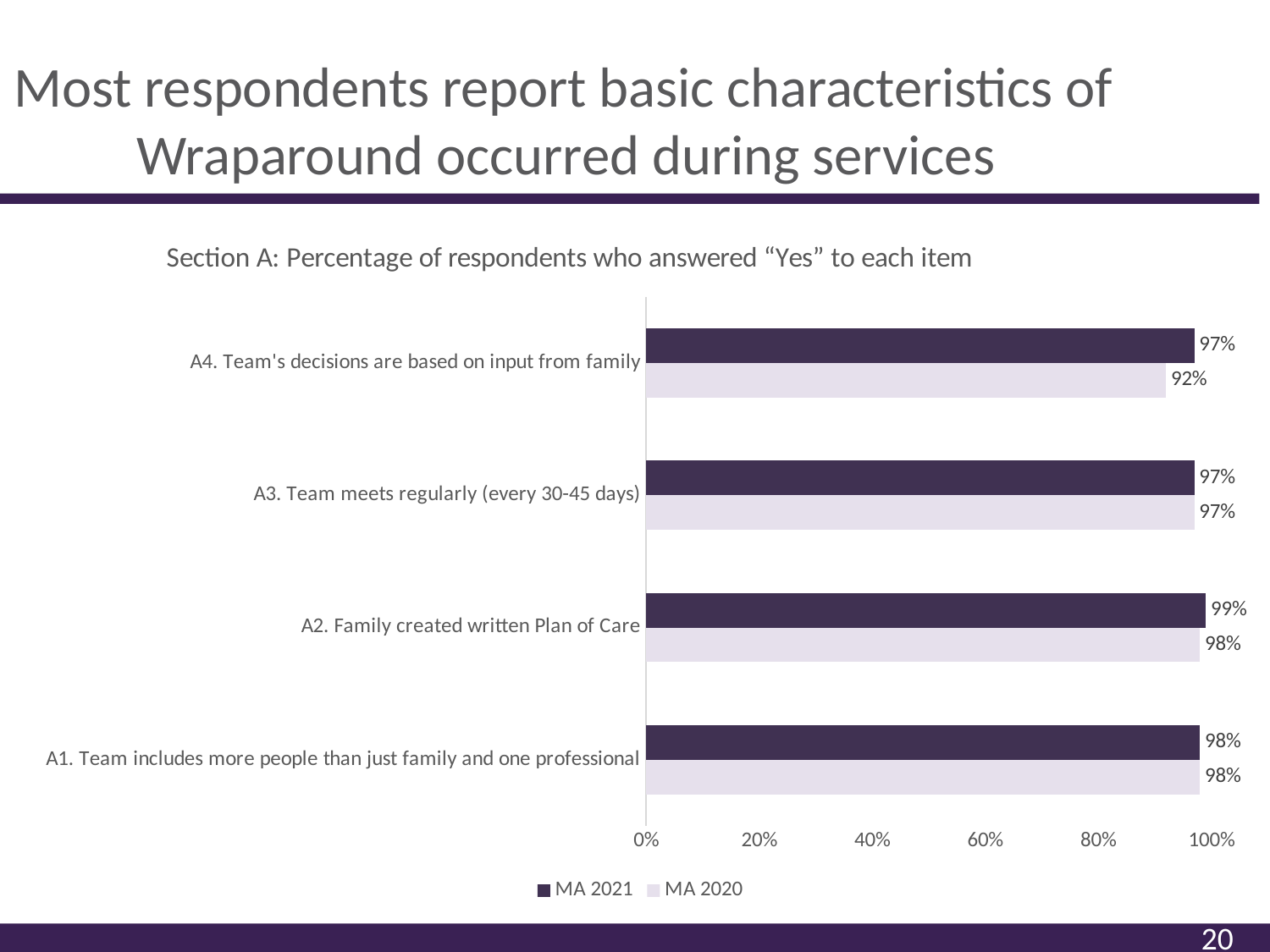
What percentage of MA 2020 respondents answered "Yes" to A4. Team's decisions are based on input from family? 92% What kind of chart is shown on the slide? Bar chart Which item has the highest MA 2021 percentage? A2. Family created written Plan of Care What percentage of MA 2021 respondents answered "Yes" to A4. Team's decisions are based on input from family? 97% What is the MA 2020 value for A3. Team meets regularly (every 30-45 days)? 97% What is the difference between the MA 2021 and MA 2020 values for A4. Team's decisions are based on input from family? 5% For A4. Team's decisions are based on input from family, which series has the larger value, MA 2021 or MA 2020? MA 2021 Which item has the lowest MA 2020 percentage? A4. Team's decisions are based on input from family How many series does the legend list? 2 How many items are shown on the chart? 4 What is the MA 2021 value for A2. Family created written Plan of Care? 99% What is the title of the chart? Section A: Percentage of respondents who answered "Yes" to each item